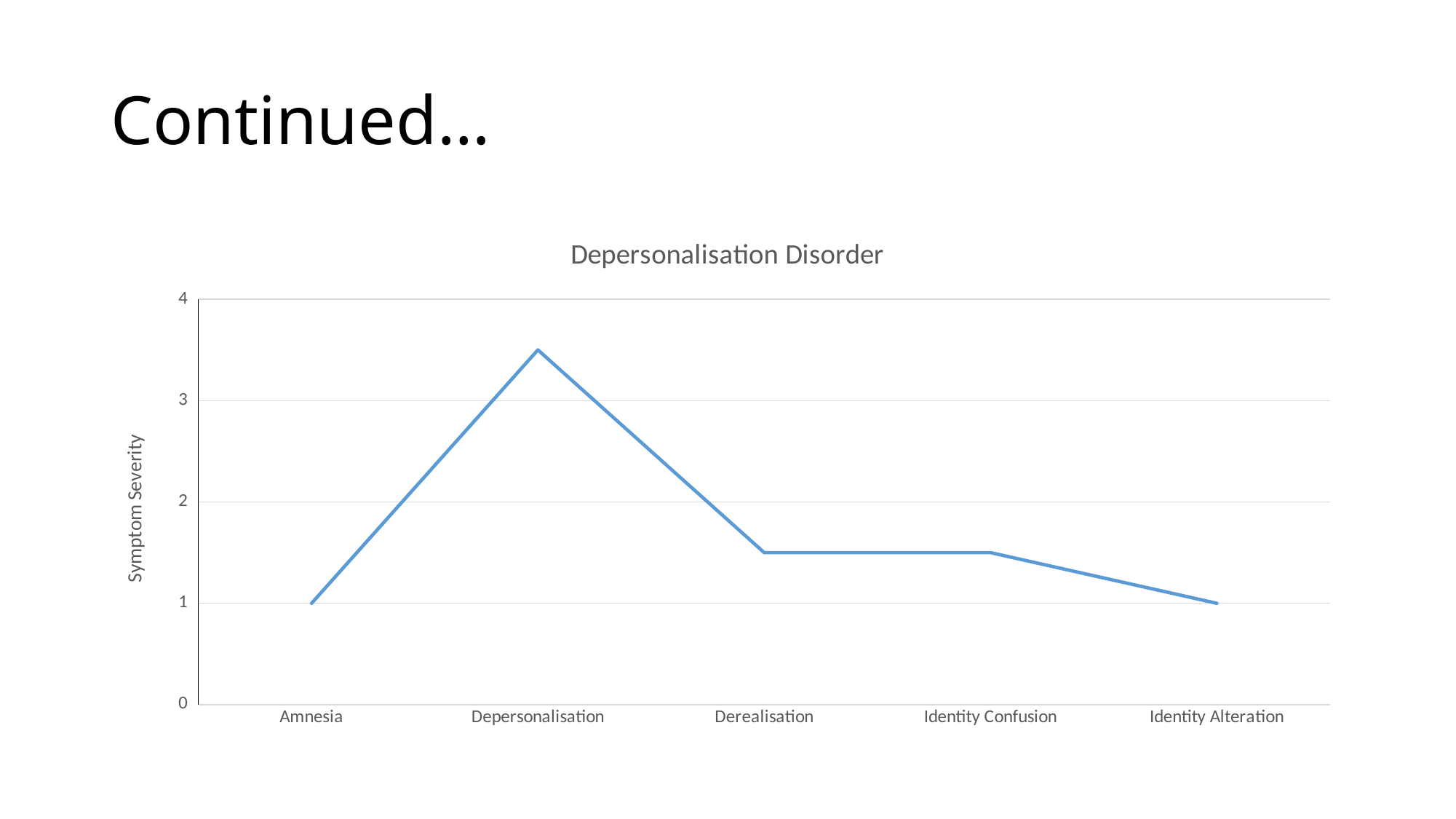
Is the value for Identity Confusion greater or less than 1? greater What type of chart is shown on the slide? line chart Does the line rise or fall from Depersonalisation to Identity Alteration? fall Which has a higher symptom severity, Depersonalisation or Derealisation? Depersonalisation What is the title of the chart? Depersonalisation Disorder What is the label on the vertical axis of the chart? Symptom Severity Is the value for Derealisation greater or less than 2? less What is the symptom severity value for Identity Alteration? 1 How many symptom categories are plotted along the x axis? 5 Is the value for Depersonalisation greater or less than 3? greater What is the symptom severity value for Amnesia? 1 Which symptom has the highest severity value? Depersonalisation